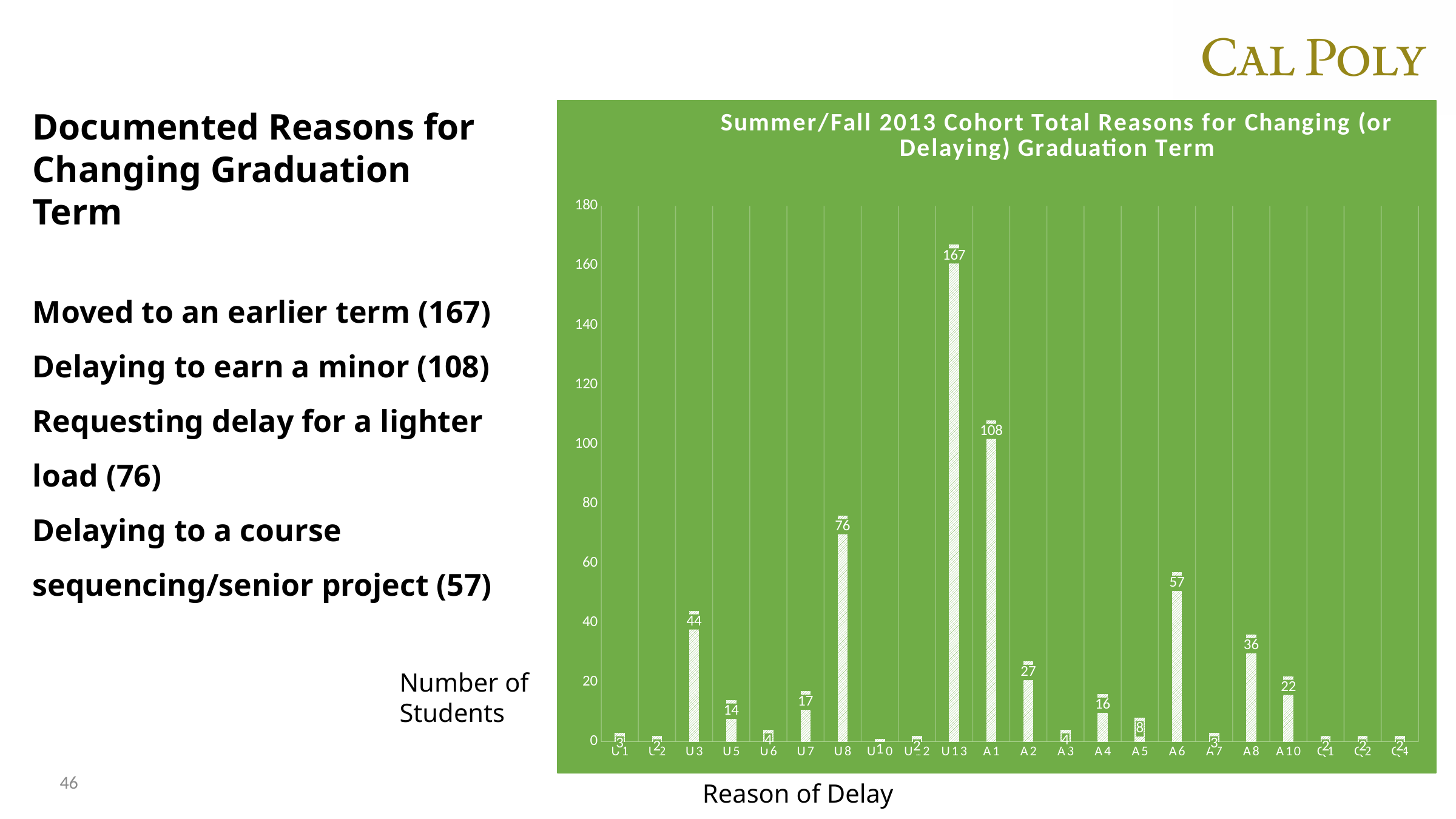
What is the value for A1? 108 How many categories are shown on the x axis? 22 What is the value for U13? 167 Which is larger, the value for U3 or the value for A8? U3 Which category has the lowest value? U10 What is the value for A6? 57 What kind of chart is shown? Bar chart What is the difference between the values for U13 and A1? 59 What is the x-axis label of the chart? Reason of Delay Which category has the highest value? U13 What is the value for A10? 22 What is the value for U8? 76